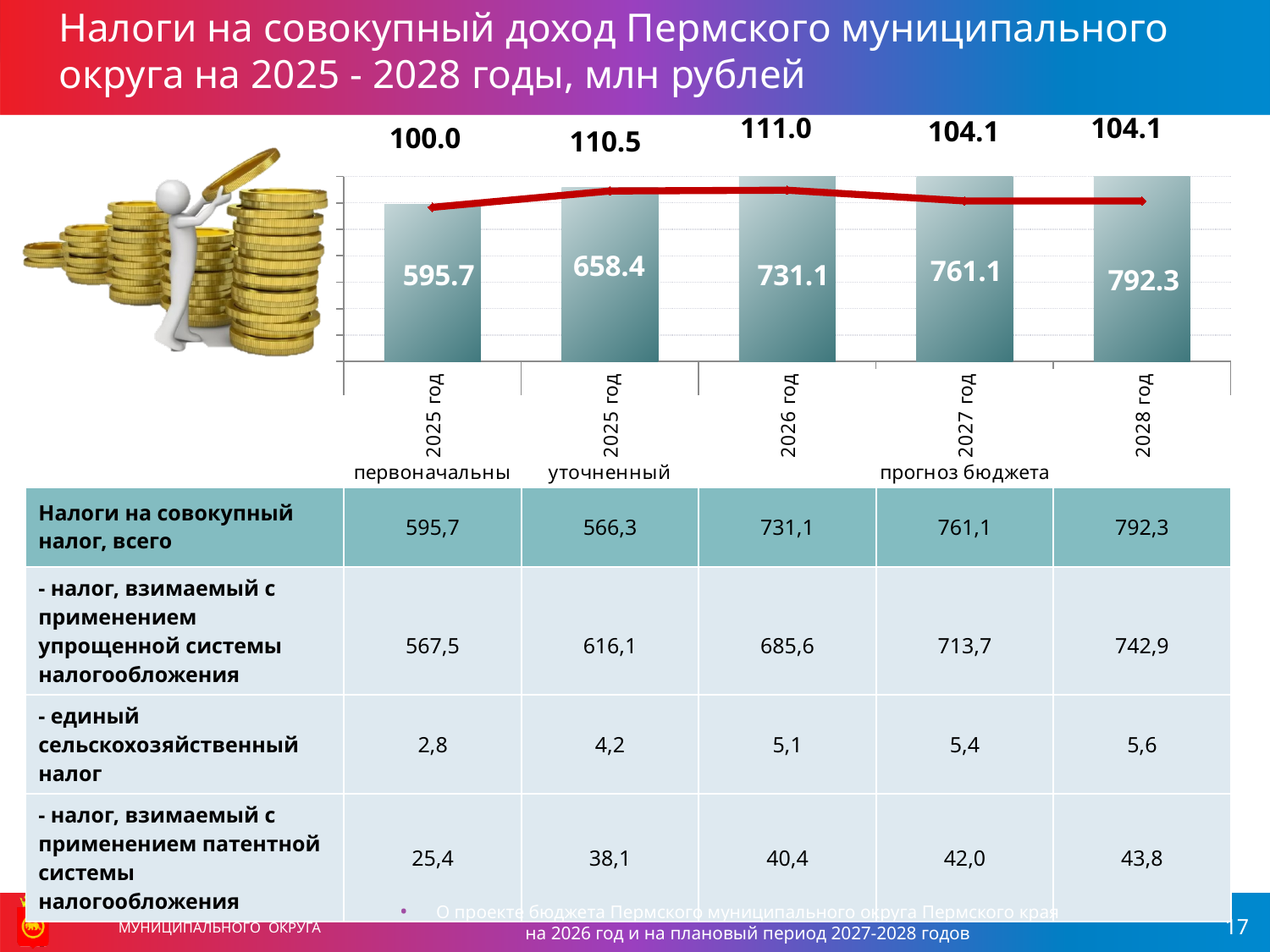
What is the value of the bar for 2028 год? 792.3 What is the value of the bar for 2026 год? 731.1 What is the difference between the bar values for 2026 год and 2025 год первоначальный? 135.4 What is the value of the bar for 2025 год первоначальный? 595.7 What is the value of the line point above the 2025 год уточненный bar? 110.5 How many bars are plotted in the chart? 5 Which category has the lowest bar? 2025 год первоначальный What is the difference between the bar values for 2028 год and 2027 год? 31.2 Which bar is larger, 2027 год or 2026 год? 2027 год What kind of chart is shown on the slide? Bar chart with a line Which category has the highest bar? 2028 год Do the bar values rise or fall from 2025 год первоначальный to 2028 год? Rise